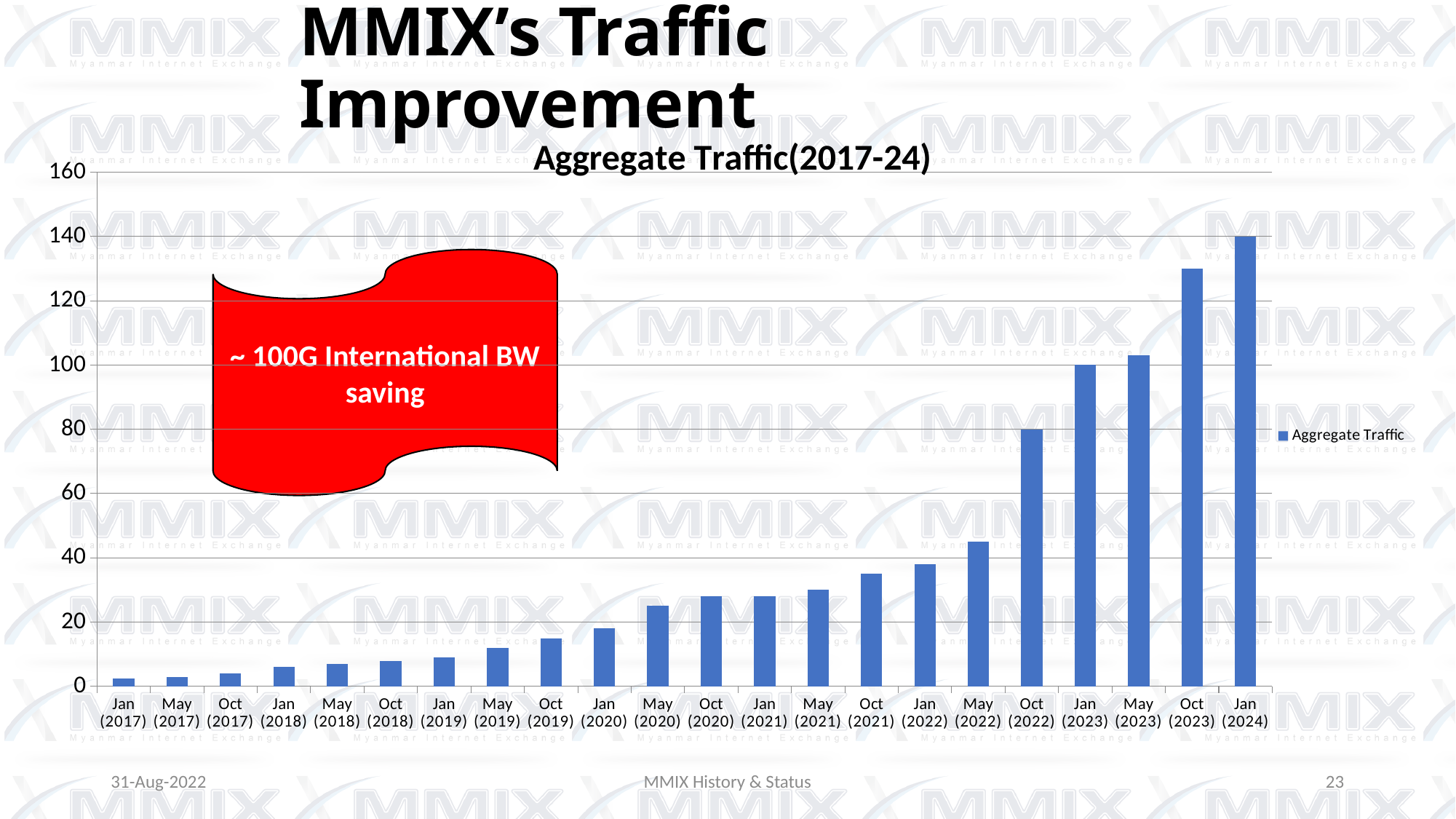
Is the value for May (2022) greater or less than 60? less What series name is shown in the chart legend? Aggregate Traffic Which period has the highest aggregate traffic? Jan (2024) What is the title of the chart? Aggregate Traffic(2017-24) Do the aggregate traffic values rise or fall from Jan (2017) to Jan (2024)? rise How many bars (time periods) are plotted in the Aggregate Traffic chart? 22 Is the value for Oct (2021) greater or less than 40? less How many series does the legend of the chart list? 1 Which period has the lowest aggregate traffic? Jan (2017) What kind of chart is shown on the slide? bar chart Is the value for Oct (2023) greater or less than 120? greater Which is larger, the value for Oct (2022) or the value for May (2023)? May (2023)